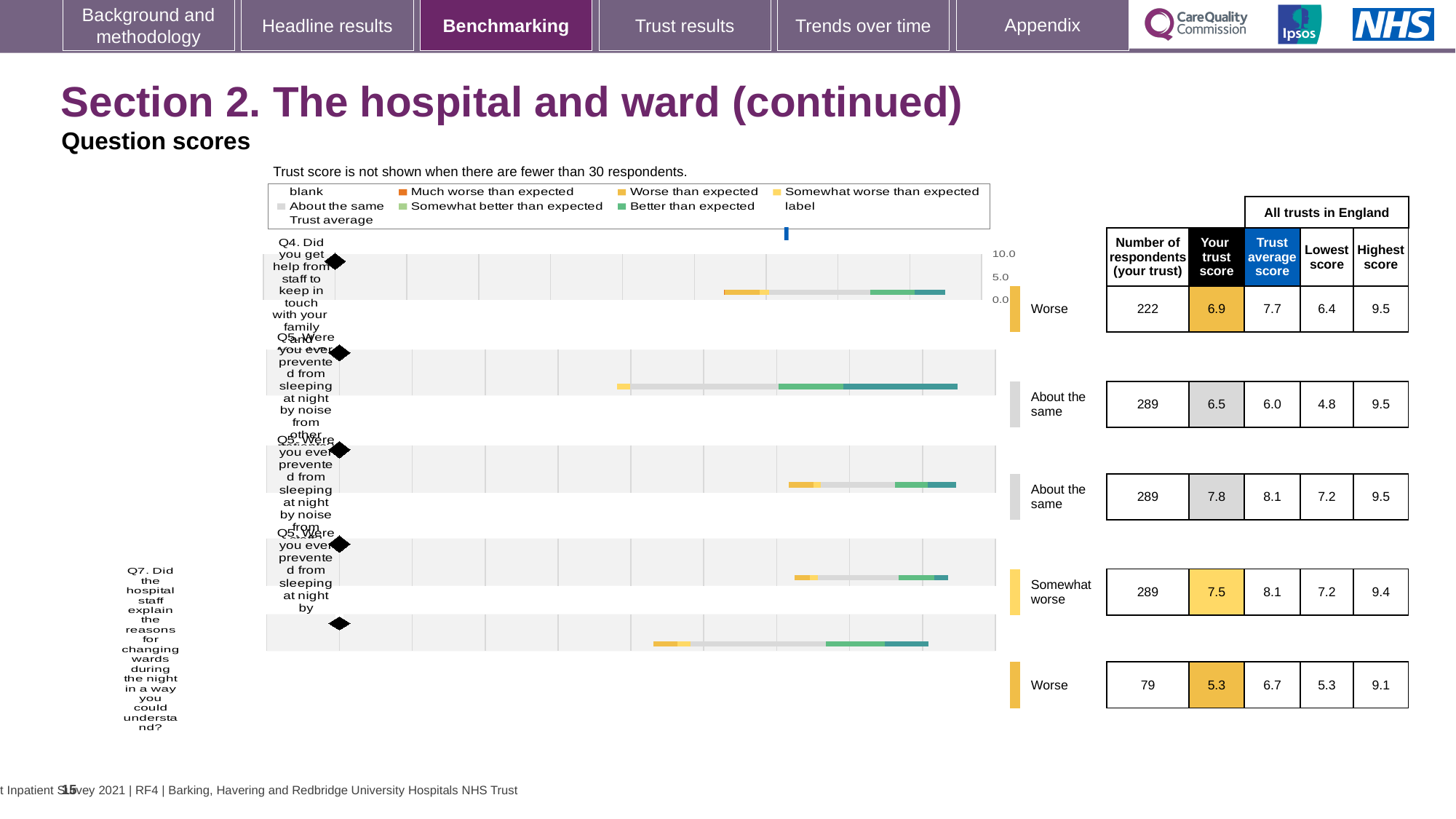
What benchmark category is shown for Q4? Worse What is the 'Your trust score' for Q7 (explaining reasons for changing wards during the night)? 5.3 How many question rows are plotted in the chart? 5 Which question row has the lowest 'Your trust score'? Q7 What is the trust average score for Q7? 6.7 What is the highest value shown on the chart's score axis? 10.0 What is the difference between the trust average score and 'Your trust score' for Q7? 1.4 What is the 'Your trust score' for Q4 (help from staff to keep in touch with family)? 6.9 For Q4, which is larger: 'Your trust score' or the trust average score? Trust average score What kind of chart is shown on the slide? bar chart What is the difference between the trust average score and 'Your trust score' for Q4? 0.8 How many respondents are shown for Q4? 222